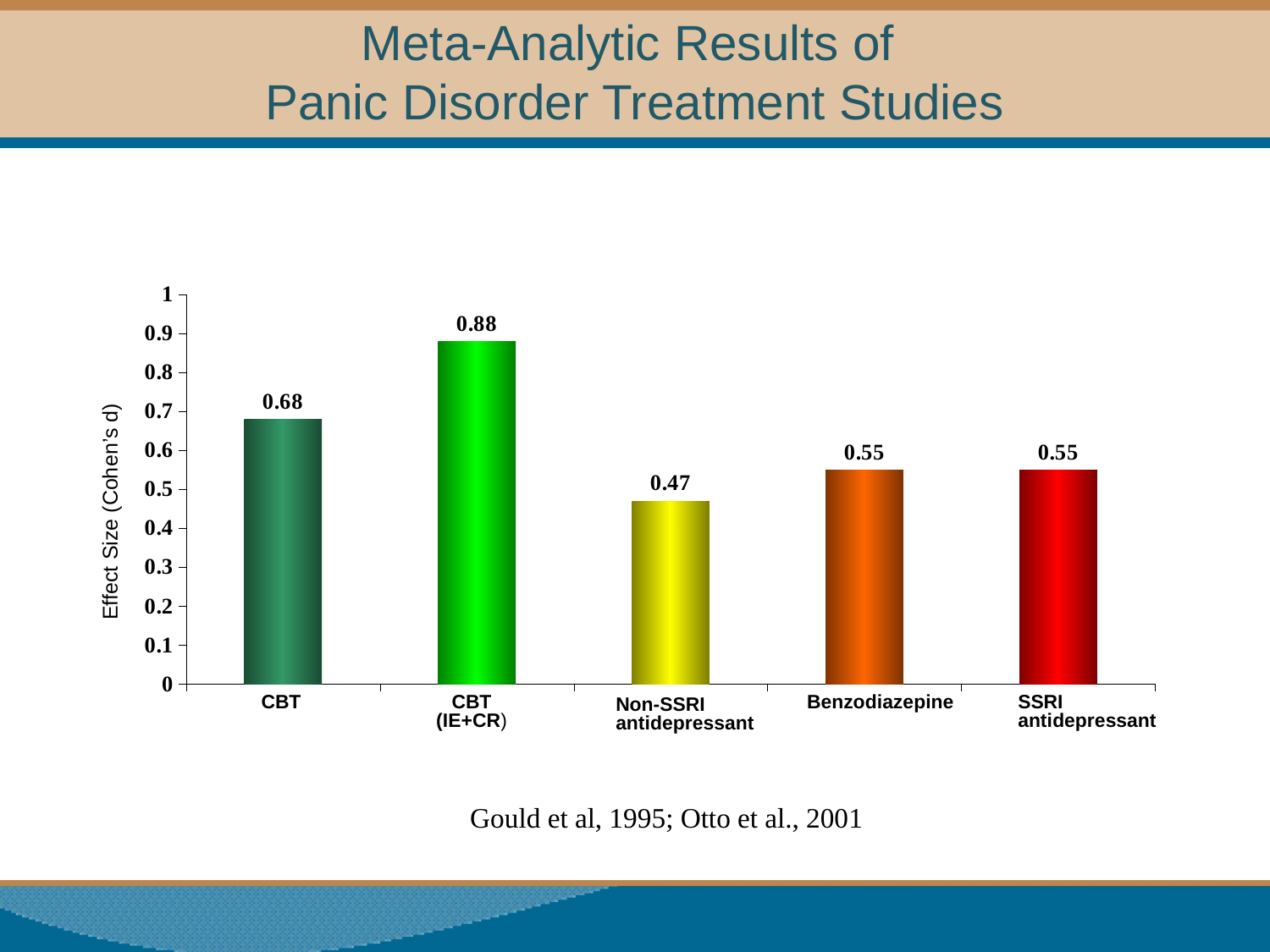
What is the difference in effect size between Benzodiazepine and Non-SSRI antidepressant? 0.08 Which has a larger effect size, CBT or SSRI antidepressant? CBT Which treatment has the lowest effect size? Non-SSRI antidepressant Which treatment has the highest effect size? CBT (IE+CR) What is the difference in effect size between CBT (IE+CR) and CBT? 0.20 What type of chart is shown on the slide? Bar chart What is the effect size for CBT? 0.68 What is the effect size for Benzodiazepine? 0.55 What is the effect size for CBT (IE+CR)? 0.88 What is the effect size for Non-SSRI antidepressant? 0.47 What is the label of the y-axis? Effect Size (Cohen's d) How many treatment categories are shown in the chart? 5